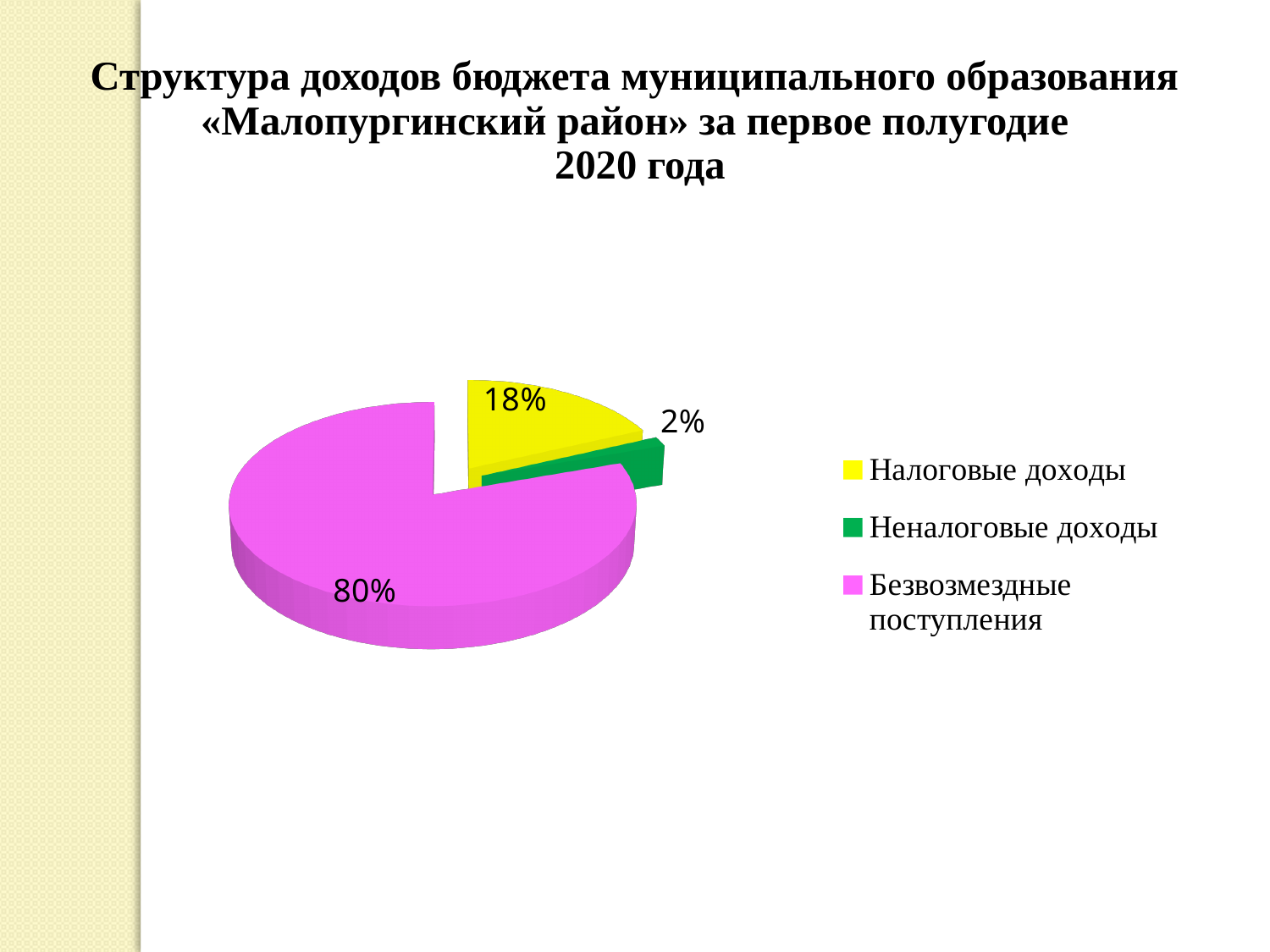
What is the difference in percentage points between Налоговые доходы and Неналоговые доходы? 16 What share of the pie does Неналоговые доходы have? 2% How many categories are shown in the pie chart? 3 Which is larger, Налоговые доходы or Неналоговые доходы? Налоговые доходы Which category has the largest slice of the pie? Безвозмездные поступления What colour is the slice for Безвозмездные поступления? pink What colour is the slice for Налоговые доходы? yellow What kind of chart is shown on the slide? pie chart What is the difference in percentage points between Безвозмездные поступления and Налоговые доходы? 62 What share of the pie does Безвозмездные поступления have? 80% Which category has the smallest slice of the pie? Неналоговые доходы What share of the pie does Налоговые доходы have? 18%